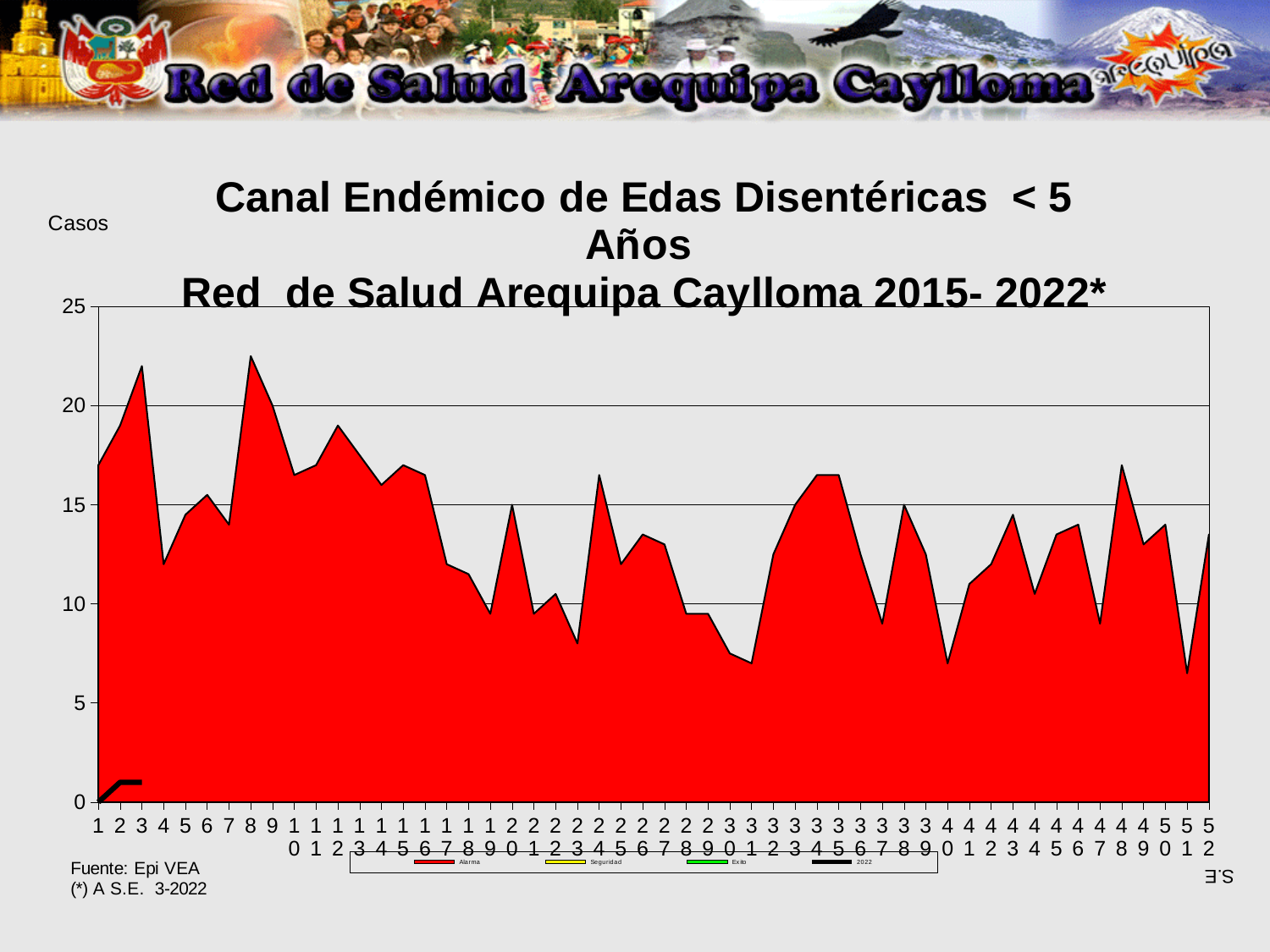
What colour is the Alarma series in the chart? Red Is the Alarma value for week 51 greater or less than 10? less Is the Alarma value for week 1 greater or less than 15? greater Is the Alarma value for week 4 greater or less than 15? less How many epidemiological weeks are shown along the x axis? 52 How many series does the legend list? 4 Which is larger, the Alarma value for week 8 or the Alarma value for week 4? Week 8 What kind of chart is shown on the slide? Area chart What label is shown on the y axis of the chart? Casos